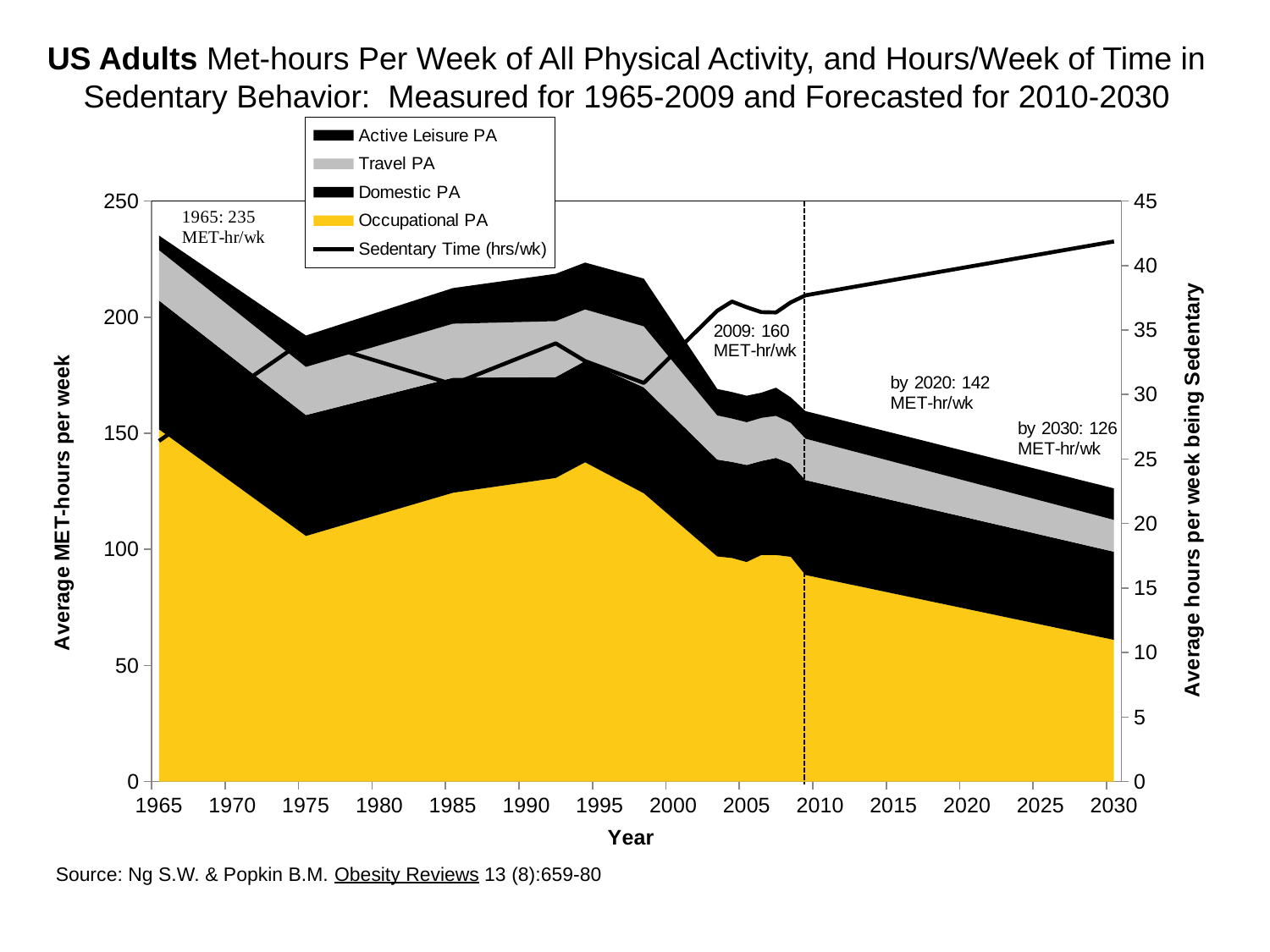
What is the difference between the forecasted totals for 2020 and 2030? 16 MET-hr/wk By how many MET-hr/wk did total physical activity fall from 1965 to 2009, using the annotated values? 75 MET-hr/wk What was the total MET-hours per week of physical activity in 2009, according to the annotation? 160 MET-hr/wk Which series is shown in yellow? Occupational PA What was the total MET-hours per week of physical activity in 1965, according to the annotation? 235 MET-hr/wk How many series does the legend list? 5 Does Sedentary Time rise or fall over the forecast period 2010-2030? Rise Is the Occupational PA value in 2030 greater or less than 100 MET-hours per week? less What is the forecasted total MET-hours per week by 2030? 126 MET-hr/wk What kind of chart is shown on the slide? Stacked area chart with a line overlay Which year has the larger annotated total MET-hours per week, 1965 or 2030? 1965 Does total MET-hours per week of physical activity rise or fall from 1965 to 2030? Fall